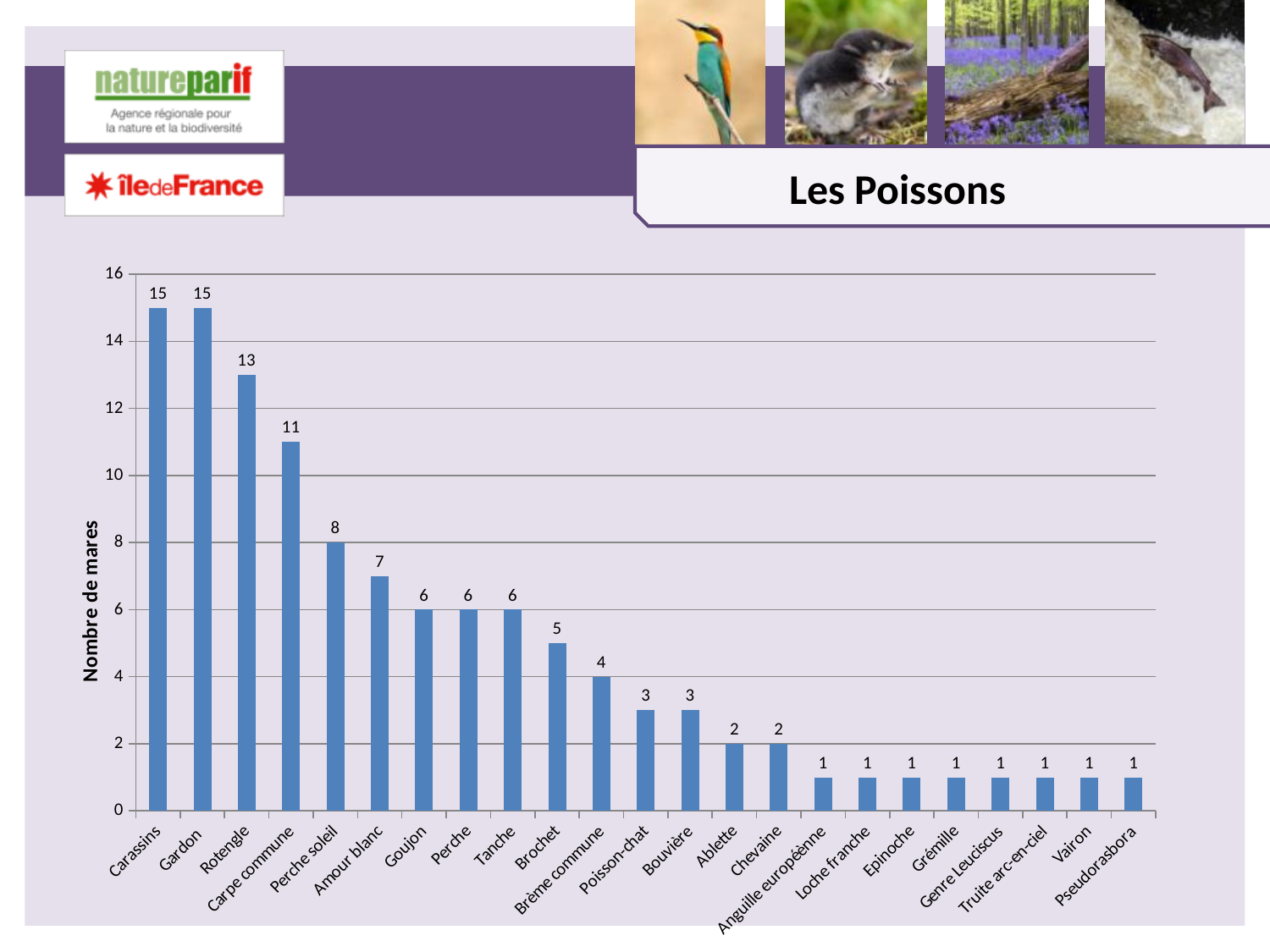
Do the values generally rise or fall from left to right along the x axis? fall What is the highest value plotted on the chart? 15 What type of chart is shown on the slide? bar chart Which has a larger value, Amour blanc or Brème commune? Amour blanc What is the lowest value plotted on the chart? 1 What is the difference between the values for Carassins and Perche soleil? 7 What is the value shown for Carpe commune? 11 How many fish categories are shown on the x axis? 23 What is the value shown for Brochet? 5 What is the value shown for Pseudorasbora? 1 What is the label of the y axis? Nombre de mares What is the number of mares (Nombre de mares) for Rotengle? 13